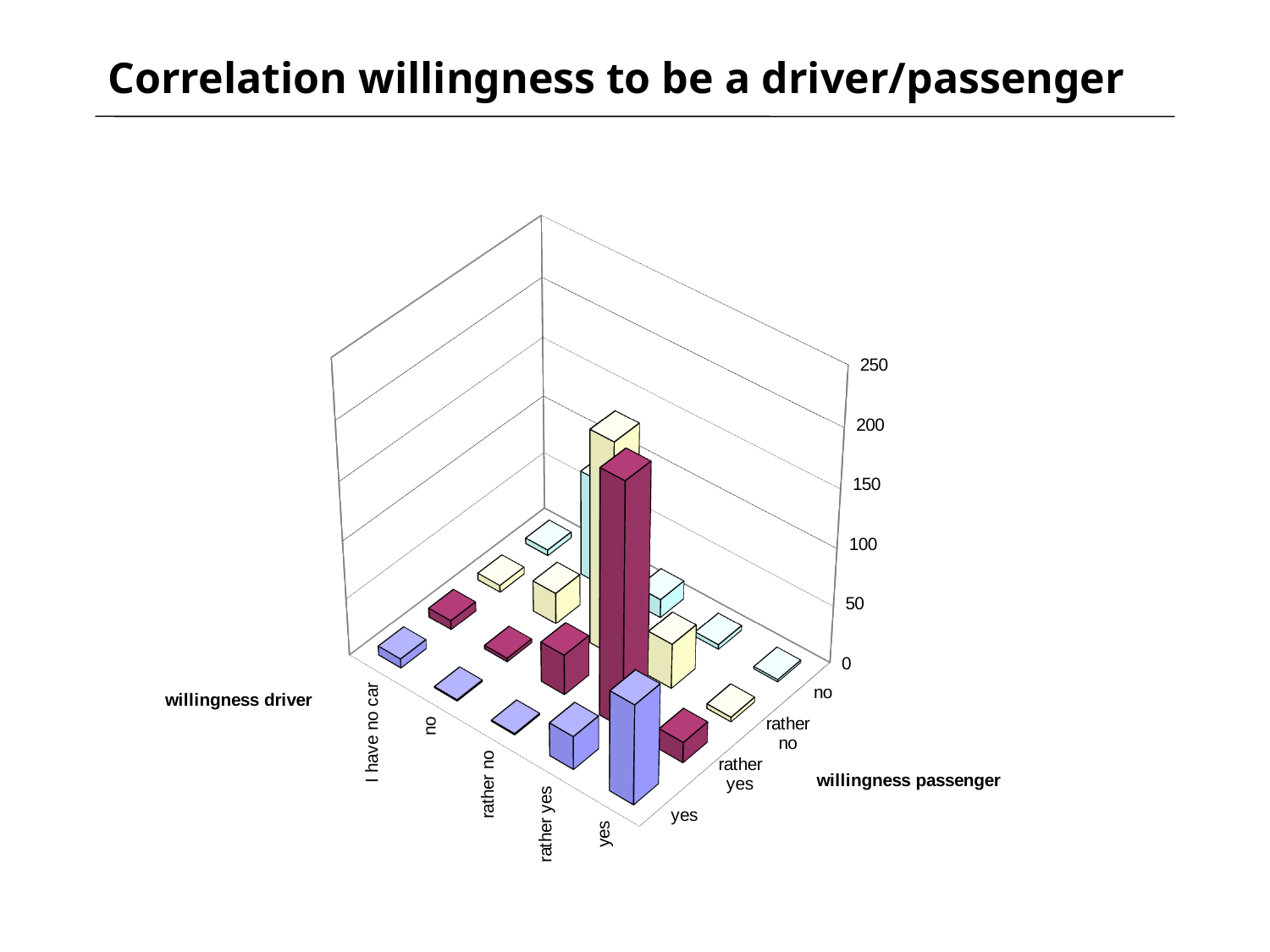
How many categories are shown on the 'willingness driver' axis? 5 What kind of chart is shown on the slide? bar chart Is the value for driver 'yes' and passenger 'rather no' greater or less than 100? less Is the value for driver 'I have no car' and passenger 'no' greater or less than 50? less Is the value for driver 'no' and passenger 'yes' greater or less than 50? less What is the title of the chart? Correlation willingness to be a driver/passenger What is the highest tick value shown on the vertical axis? 250 Which is larger: the value for driver 'yes' with passenger 'rather yes', or driver 'yes' with passenger 'yes'? driver 'yes' with passenger 'yes' How many categories are shown on the 'willingness passenger' axis? 4